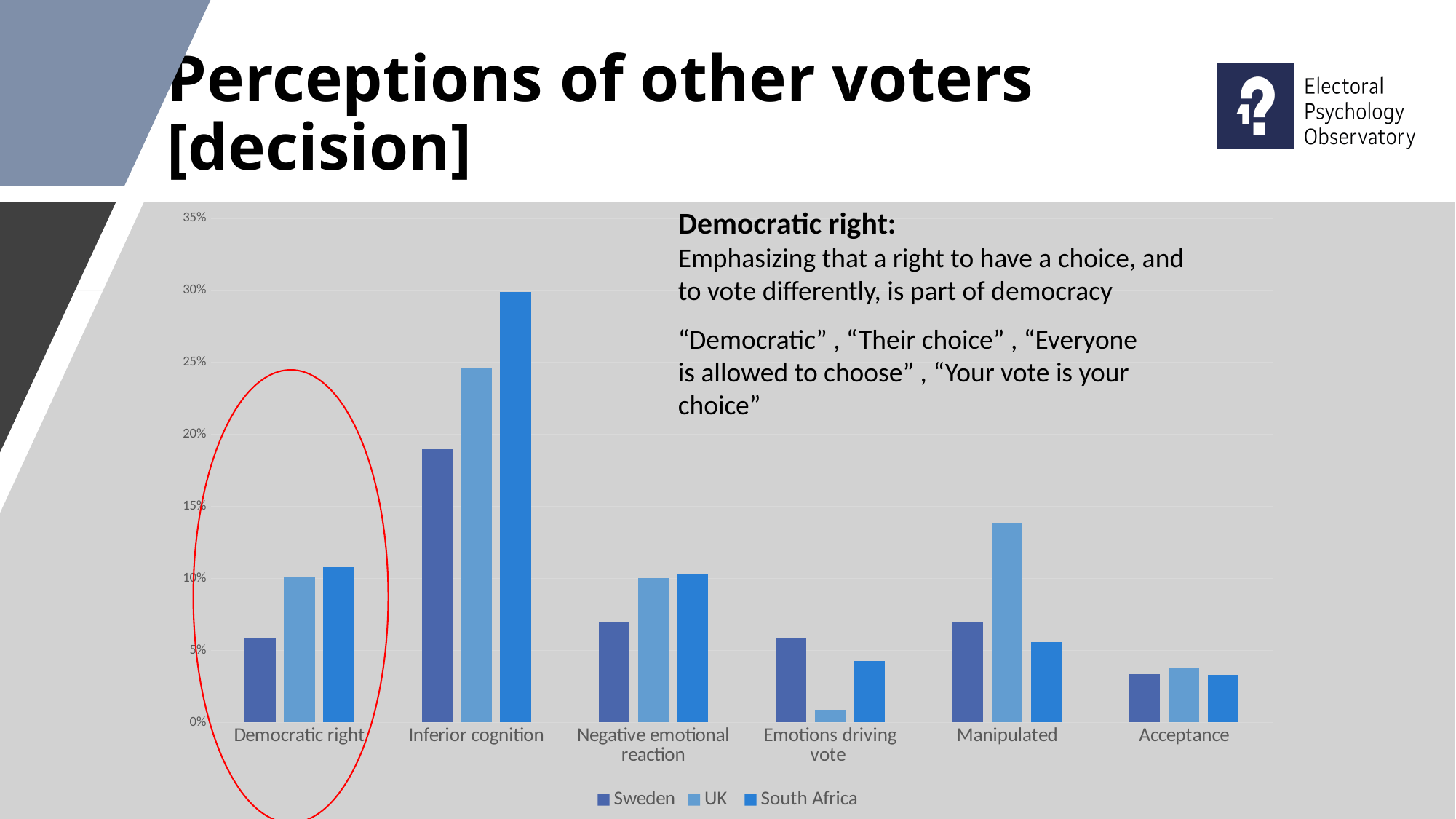
Which series are listed in the chart's legend? Sweden, UK, South Africa For which category is the South Africa bar the highest? Inferior cognition What kind of chart is shown on the slide? bar chart How many categories are shown along the x axis of the chart? 6 How many series does the chart's legend list? 3 For which category is the UK bar the lowest? Emotions driving vote Is the value for South Africa in the Inferior cognition category greater or less than 25%? greater Is the value for Sweden in the Acceptance category greater or less than 5%? less Is the value for Sweden in the Inferior cognition category greater or less than 20%? less In the Emotions driving vote category, which is larger: the Sweden value or the UK value? Sweden In the Manipulated category, which is larger: the UK value or the South Africa value? UK